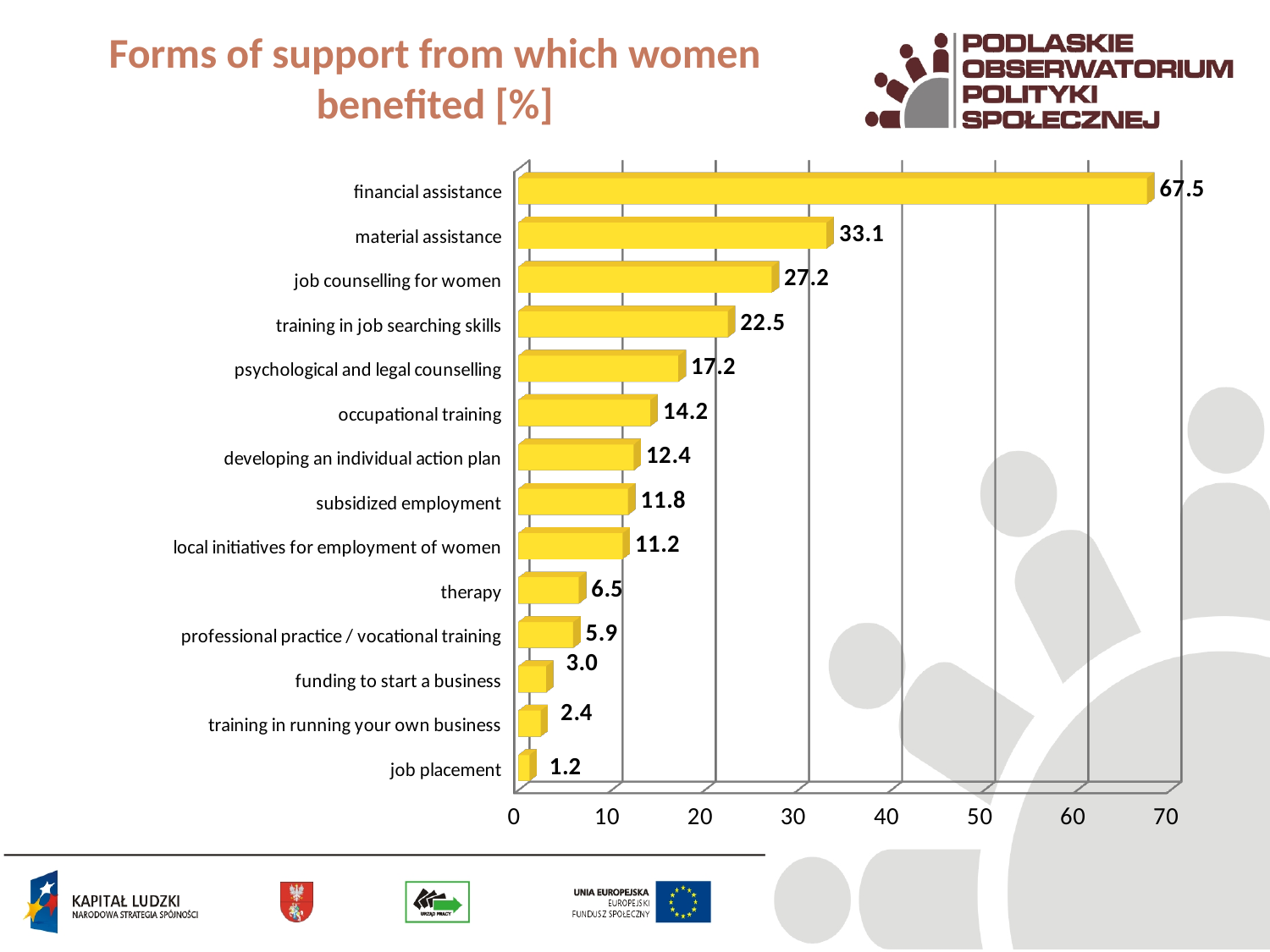
Is the value for psychological and legal counselling greater or less than 20? less Which form of support has the highest value? financial assistance What is the value for therapy? 6.5 How many forms of support are shown in the chart? 14 What is the value for occupational training? 14.2 What is the value for financial assistance? 67.5 Which is larger, the value for subsidized employment or the value for local initiatives for employment of women? subsidized employment Which form of support has the lowest value? job placement What is the difference between the values for financial assistance and material assistance? 34.4 What is the title of the chart? Forms of support from which women benefited [%] What kind of chart is shown on the slide? bar chart What is the difference between the values for job counselling for women and training in job searching skills? 4.7